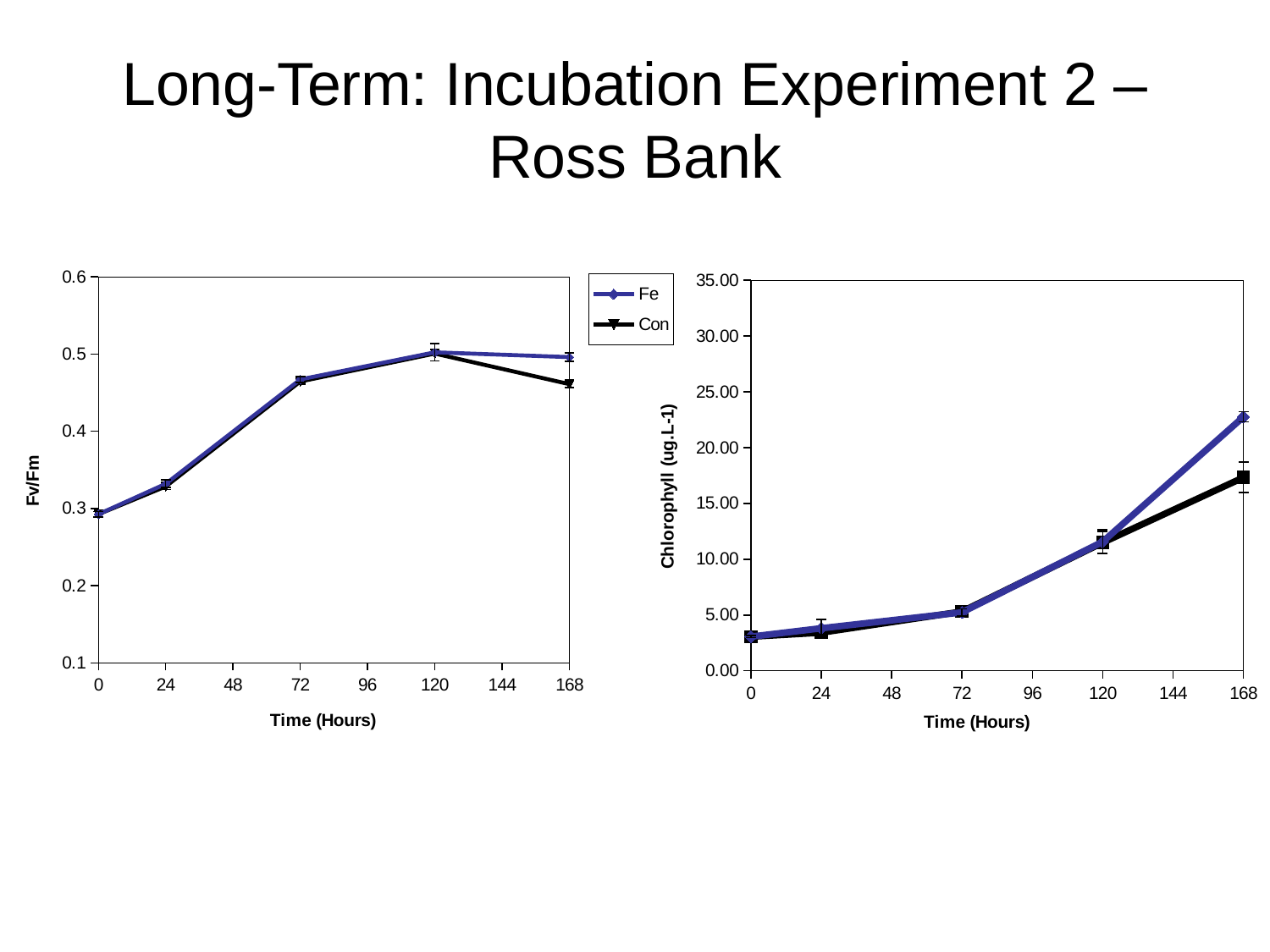
In the right chart (Chlorophyll), is the black line's value at 168 hours greater or less than 20.00? less In the right chart (Chlorophyll), how many time points are plotted along the x axis for each line? 5 What is the y-axis label of the right chart? Chlorophyll (ug.L-1) In the left chart (Fv/Fm), what are the names of the two series in the legend? Fe and Con In the right chart (Chlorophyll), is the blue line's value at 168 hours greater or less than 20.00? greater In the right chart (Chlorophyll), do the values generally rise or fall as time increases from 0 to 168 hours? rise In the left chart (Fv/Fm), is the Con value at 168 hours greater or less than 0.5? less What kind of chart is the left chart (Fv/Fm vs Time)? line chart In the left chart (Fv/Fm), how many series does the legend list? 2 In the left chart (Fv/Fm), at 168 hours, which series has the higher value, Fe or Con? Fe What kind of chart is the right chart (Chlorophyll vs Time)? line chart